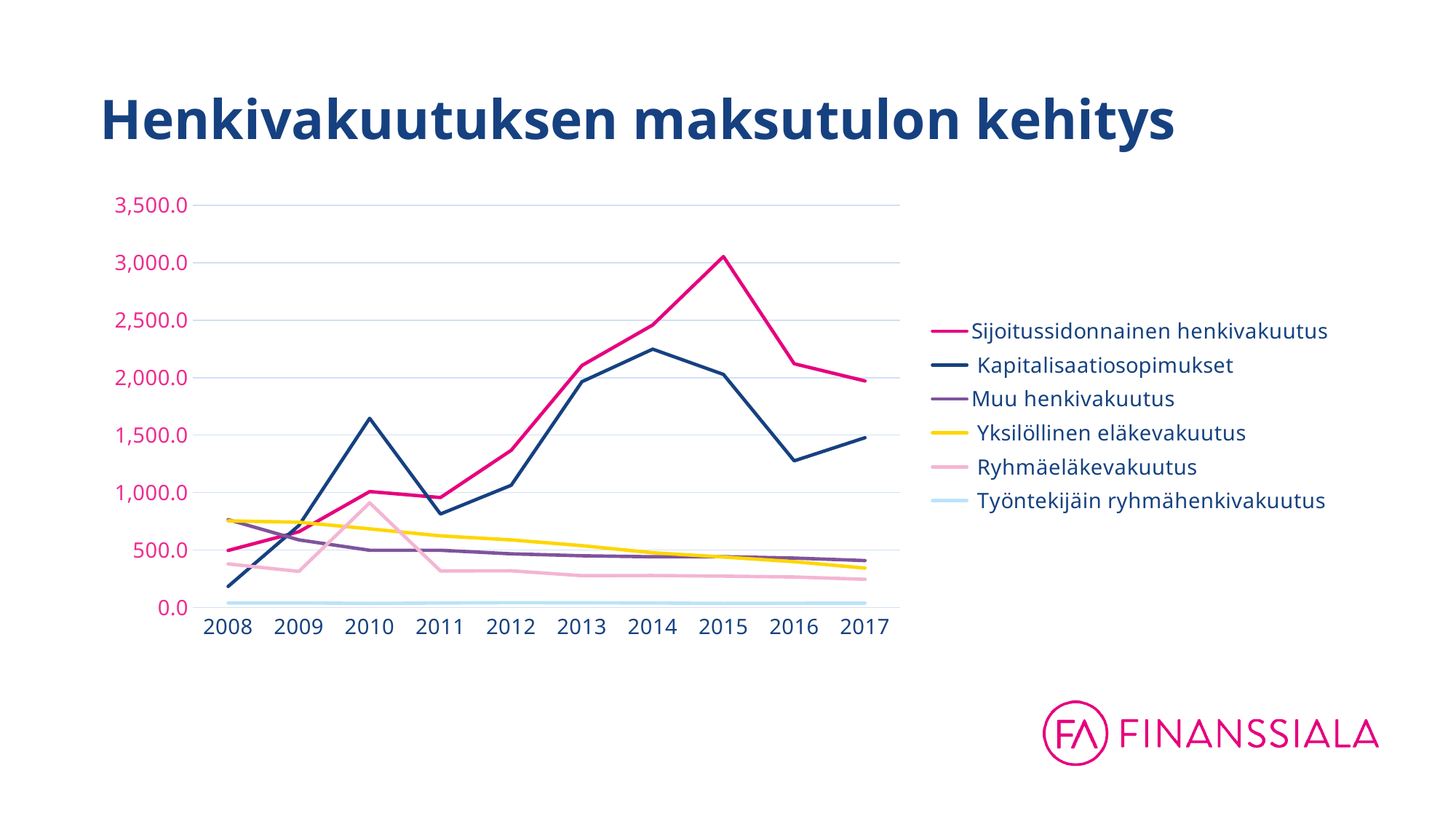
How many series does the legend list? 6 Which is larger in 2008, Sijoitussidonnainen henkivakuutus or Kapitalisaatiosopimukset? Sijoitussidonnainen henkivakuutus In which year is Kapitalisaatiosopimukset at its lowest? 2008 Is the value for Sijoitussidonnainen henkivakuutus in 2015 greater or less than 2,500.0? greater What kind of chart is shown on the slide? Line chart What is the title of the chart? Henkivakuutuksen maksutulon kehitys Does Yksilöllinen eläkevakuutus rise or fall from 2008 to 2017? Fall Is the value for Yksilöllinen eläkevakuutus in 2017 greater or less than 500.0? less In which year does Kapitalisaatiosopimukset reach its highest value? 2014 In which year does Sijoitussidonnainen henkivakuutus reach its highest value? 2015 How many years are shown on the x axis? 10 Is the value for Kapitalisaatiosopimukset in 2010 greater or less than 1,500.0? greater